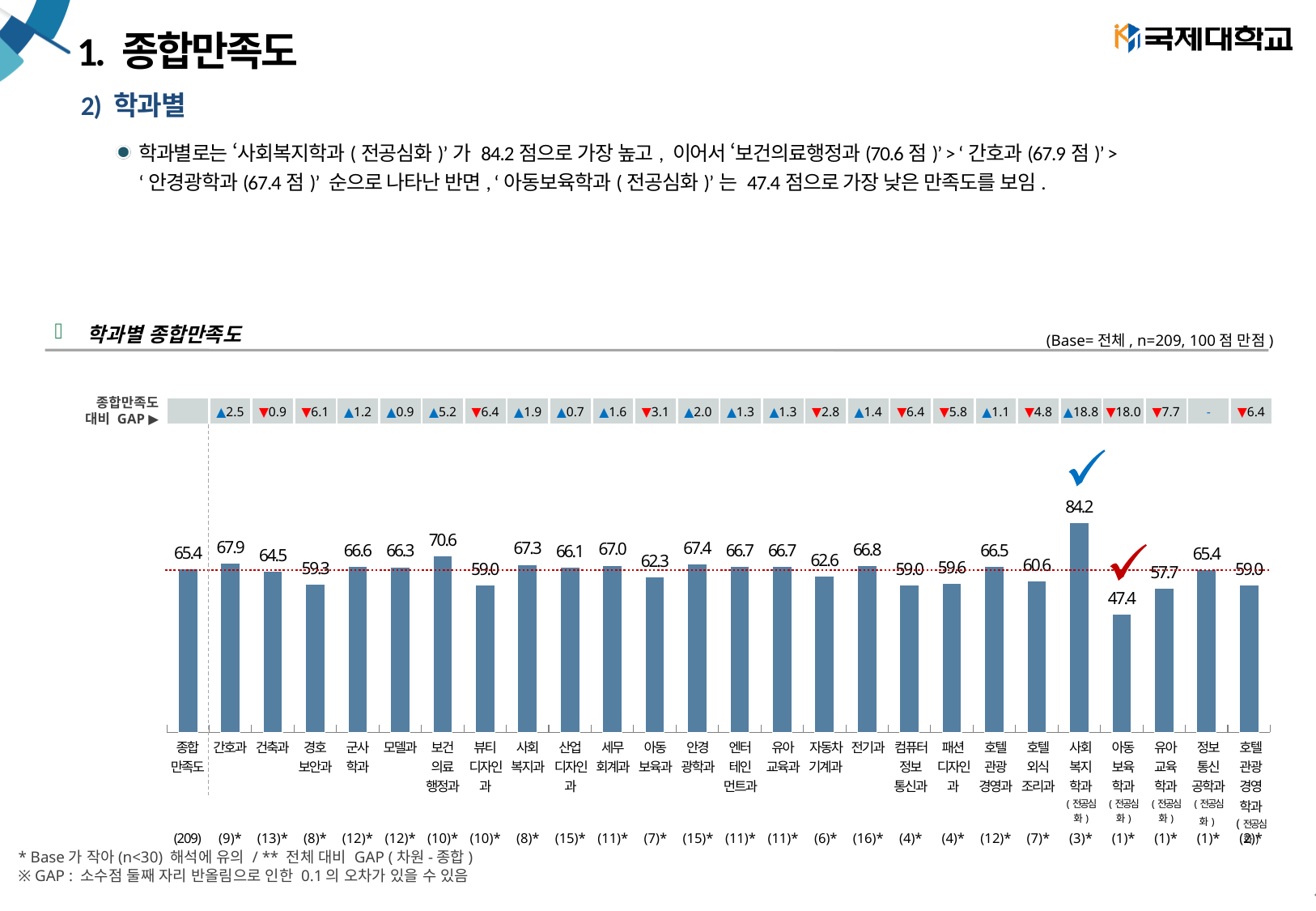
Which has a larger value in the chart, 안경광학과 or 아동보육과? 안경광학과 Which department has the lowest value in the 학과별 종합만족도 chart? 아동보육학과(전공심화) What is the difference between the values for 보건의료행정과 and 간호과? 2.7 What base size (n) is stated for the 학과별 종합만족도 chart? n=209 What is the value for 보건의료행정과 in the 학과별 종합만족도 chart? 70.6 What is the overall 종합만족도 value shown as the first bar of the chart? 65.4 What type of chart is used to show 학과별 종합만족도? bar chart What is the value for 호텔외식조리과 in the 학과별 종합만족도 chart? 60.6 Which department has the highest value in the 학과별 종합만족도 chart? 사회복지학과(전공심화) What is the difference between the highest value (사회복지학과 전공심화) and the lowest value (아동보육학과 전공심화) in the chart? 36.8 What is the GAP value shown for 사회복지학과(전공심화) in the 종합만족도 대비 GAP row? ▲18.8 What is the value for 간호과 in the 학과별 종합만족도 chart? 67.9